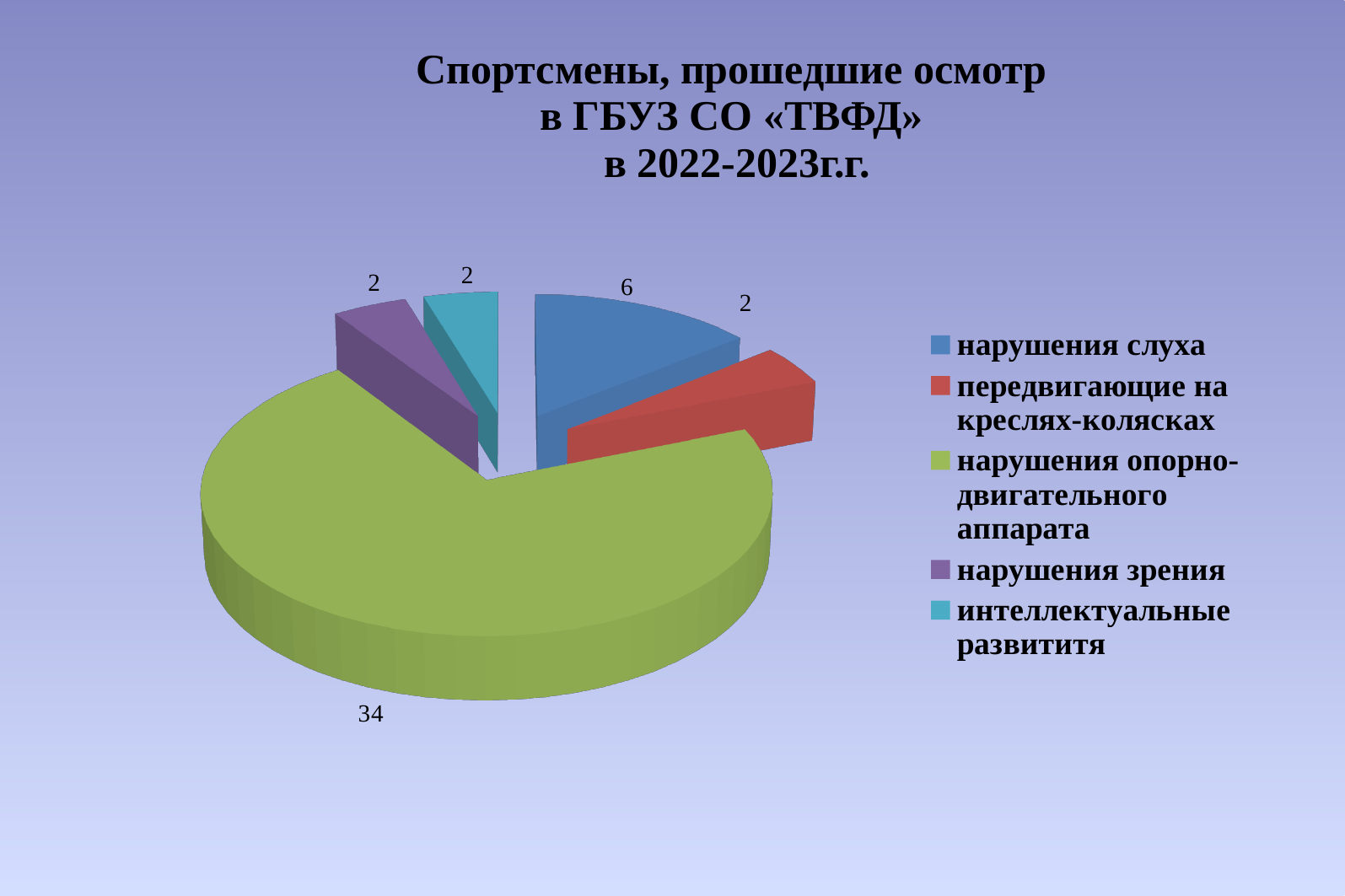
What kind of chart is shown on the slide? pie chart How many categories does the pie chart show? 5 What is the difference between the values for нарушения опорно-двигательного аппарата and нарушения слуха? 28 What is the total of all the values shown in the pie chart? 46 What is the value for передвигающие на креслях-колясках? 2 Which is larger, the value for нарушения слуха or the value for нарушения зрения? нарушения слуха What is the value for нарушения зрения? 2 What is the value for нарушения опорно-двигательного аппарата? 34 What is the value for нарушения слуха? 6 What is the difference between the values for нарушения слуха and интеллектуальные развититя? 4 Which colour represents нарушения опорно-двигательного аппарата in the legend? green Which category has the largest slice of the pie? нарушения опорно-двигательного аппарата